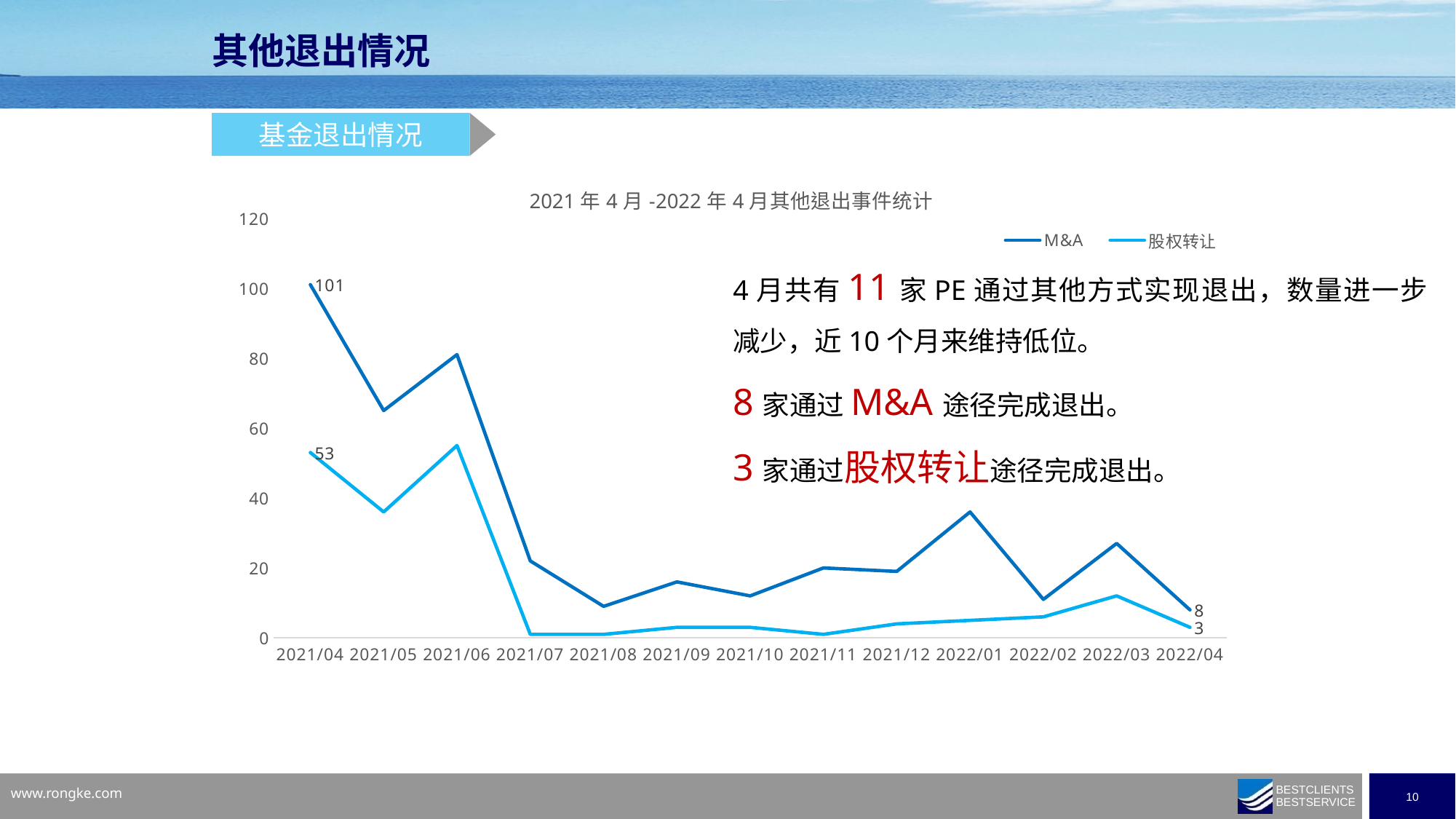
What is the M&A value for 2022/04? 8 How many months are shown on the x axis of the chart? 13 Which series has the larger value in 2022/01, M&A or 股权转让? M&A What is the title of the chart? 2021 年 4 月 -2022 年 4 月其他退出事件统计 How many series does the chart legend list? 2 What is the M&A value for 2021/04? 101 What is the 股权转让 value for 2022/04? 3 What kind of chart is shown on the slide? line chart In which month is the M&A series at its highest? 2021/04 What is the 股权转让 value for 2021/04? 53 Is the M&A value for 2021/06 greater or less than 60? greater What is the difference between the M&A and 股权转让 values in 2021/04? 48